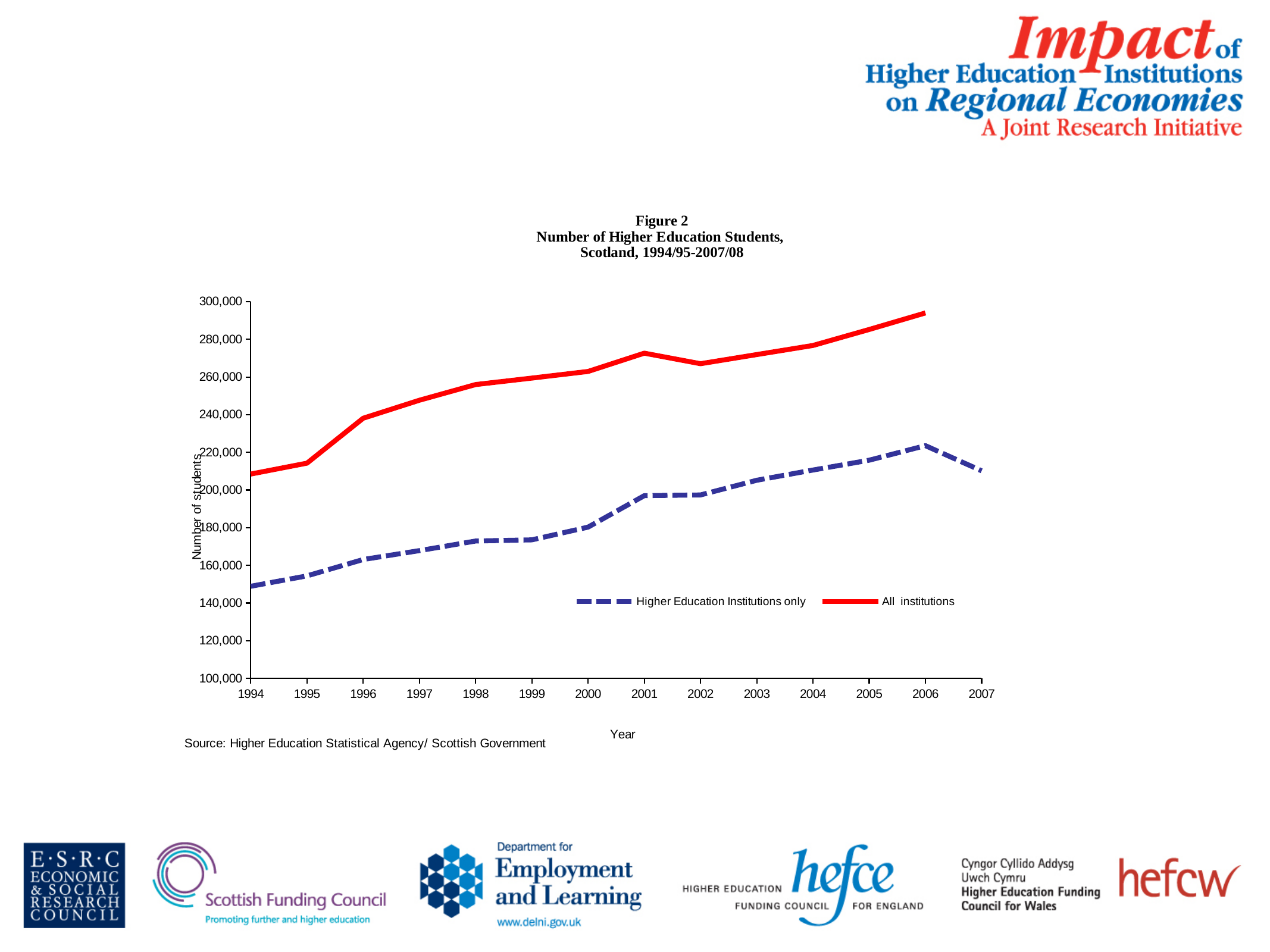
Is the value for Higher Education Institutions only in 1994 greater or less than 160,000? less In which year is the value for All institutions highest? 2006 How many years are plotted along the x axis? 14 Which series is drawn as a dashed blue line? Higher Education Institutions only What kind of chart is shown on the slide? Line chart Which series has the larger value in 2003, Higher Education Institutions only or All institutions? All institutions Is the value for All institutions in 1996 greater or less than 220,000? greater Does the All institutions line generally rise or fall from 1994 to 2007? Rise In which year is the value for Higher Education Institutions only highest? 2006 In which year is the value for All institutions lowest? 1994 How many series does the legend list? 2